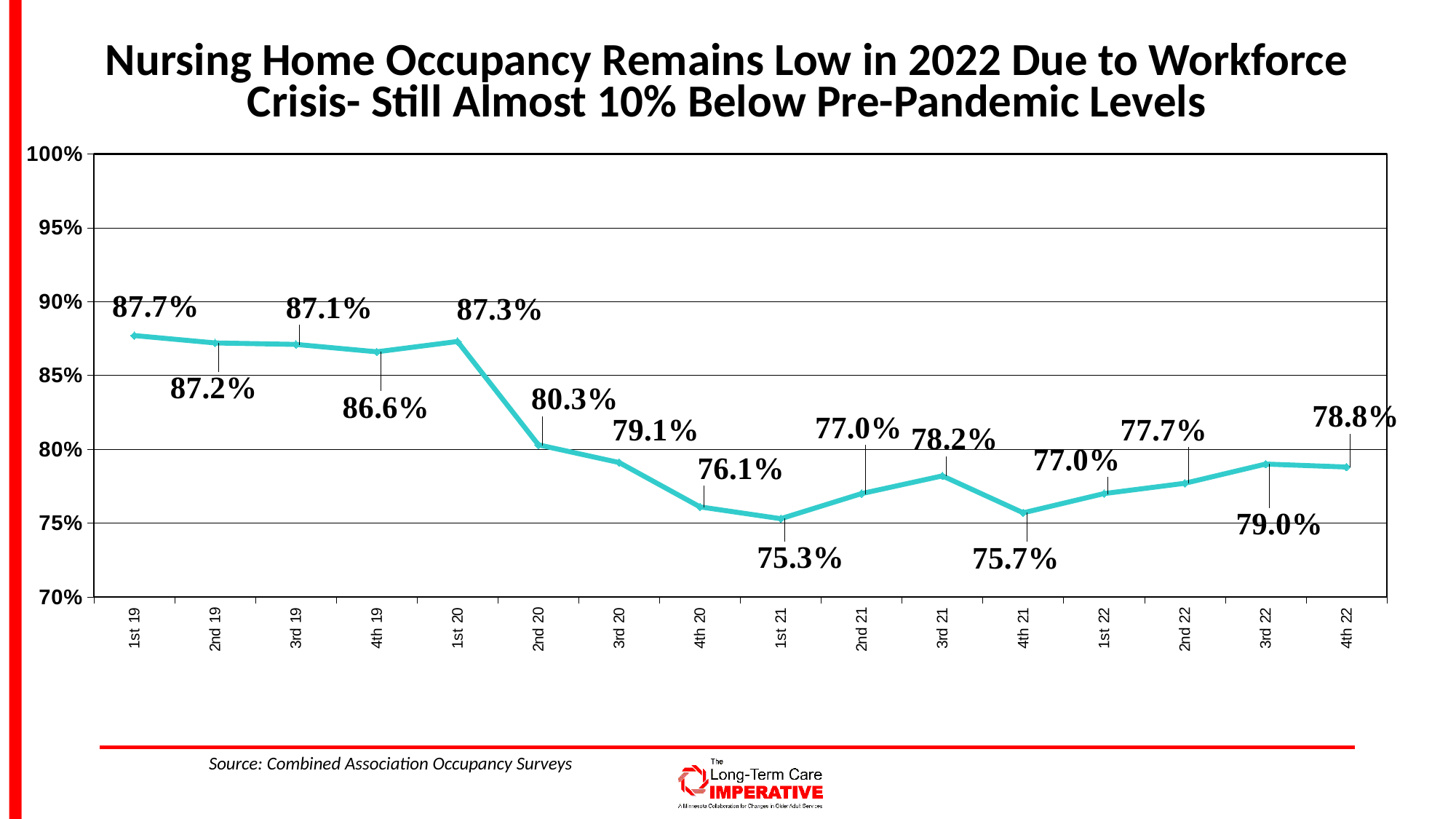
What is the difference between the occupancy values for 1st 20 and 2nd 20? 7.0% Does the occupancy value rise or fall from 1st 20 to 1st 21? fall Which is larger, the occupancy value for 3rd 21 or for 4th 21? 3rd 21 What is the occupancy value for 4th 22? 78.8% What is the source cited below the chart? Combined Association Occupancy Surveys Is the occupancy value for 4th 20 greater or less than 80%? less What type of chart is shown on the slide? line chart How many quarters are plotted on the x axis? 16 What is the occupancy value for 1st 19? 87.7% What is the occupancy value for 2nd 20? 80.3% Which quarter has the lowest occupancy value? 1st 21 Which quarter has the highest occupancy value? 1st 19